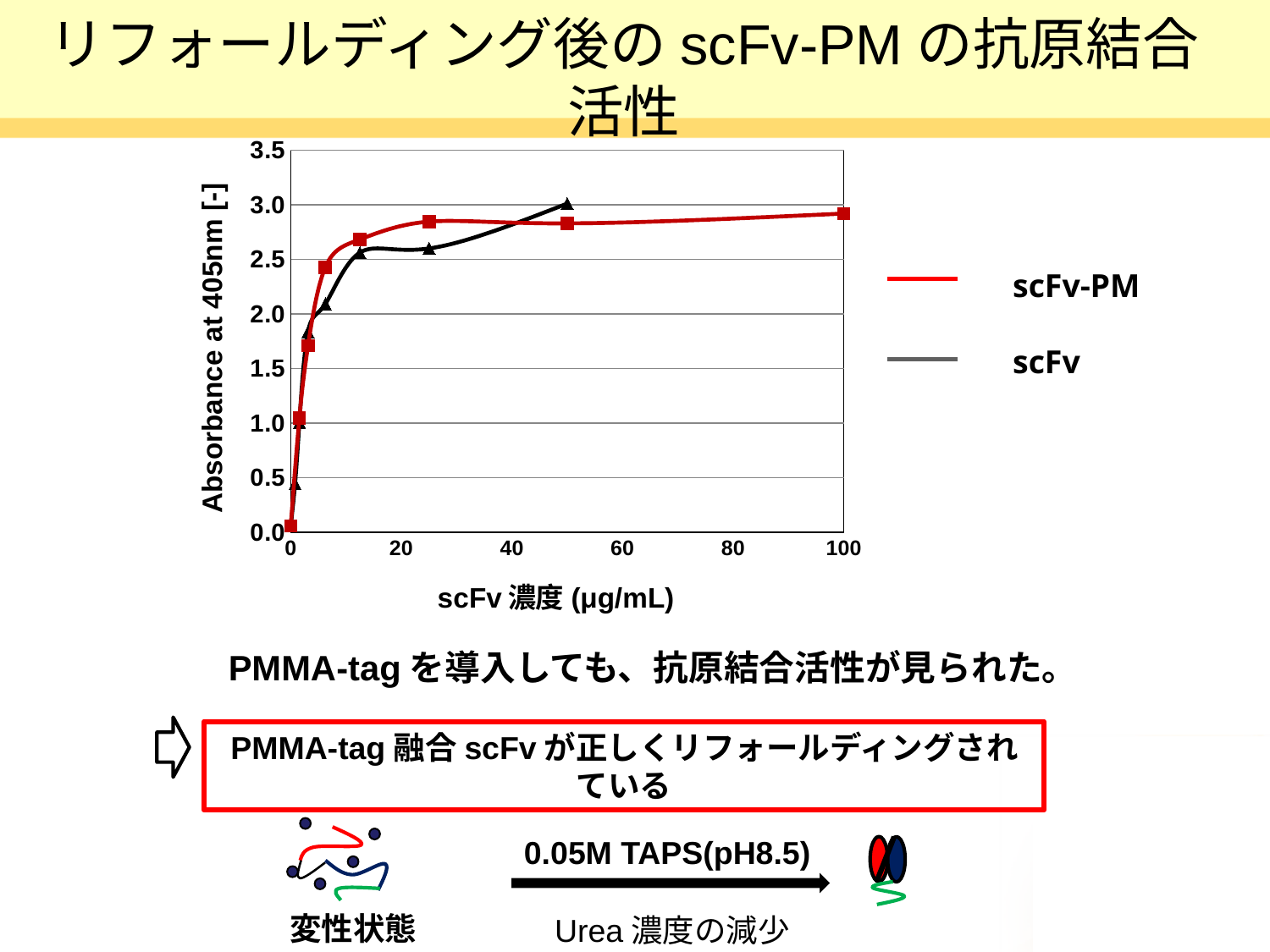
What is the label of the chart's y axis? Absorbance at 405nm [-] At about 6 µg/mL, which series has the higher absorbance, scFv-PM or scFv? scFv-PM Does the absorbance for scFv-PM generally rise or fall as the scFv concentration increases? rise How many data points are plotted for the scFv series? 7 What are the two series named in the chart's legend? scFv-PM and scFv Is the absorbance for scFv at 50 µg/mL greater or less than 2.5? greater How many series does the chart's legend list? 2 Is the absorbance for scFv at 0 µg/mL greater or less than 1.0? less What kind of chart is shown on the slide? line chart Is the absorbance for scFv-PM at 25 µg/mL greater or less than 2.0? greater At 50 µg/mL, which series has the higher absorbance, scFv-PM or scFv? scFv